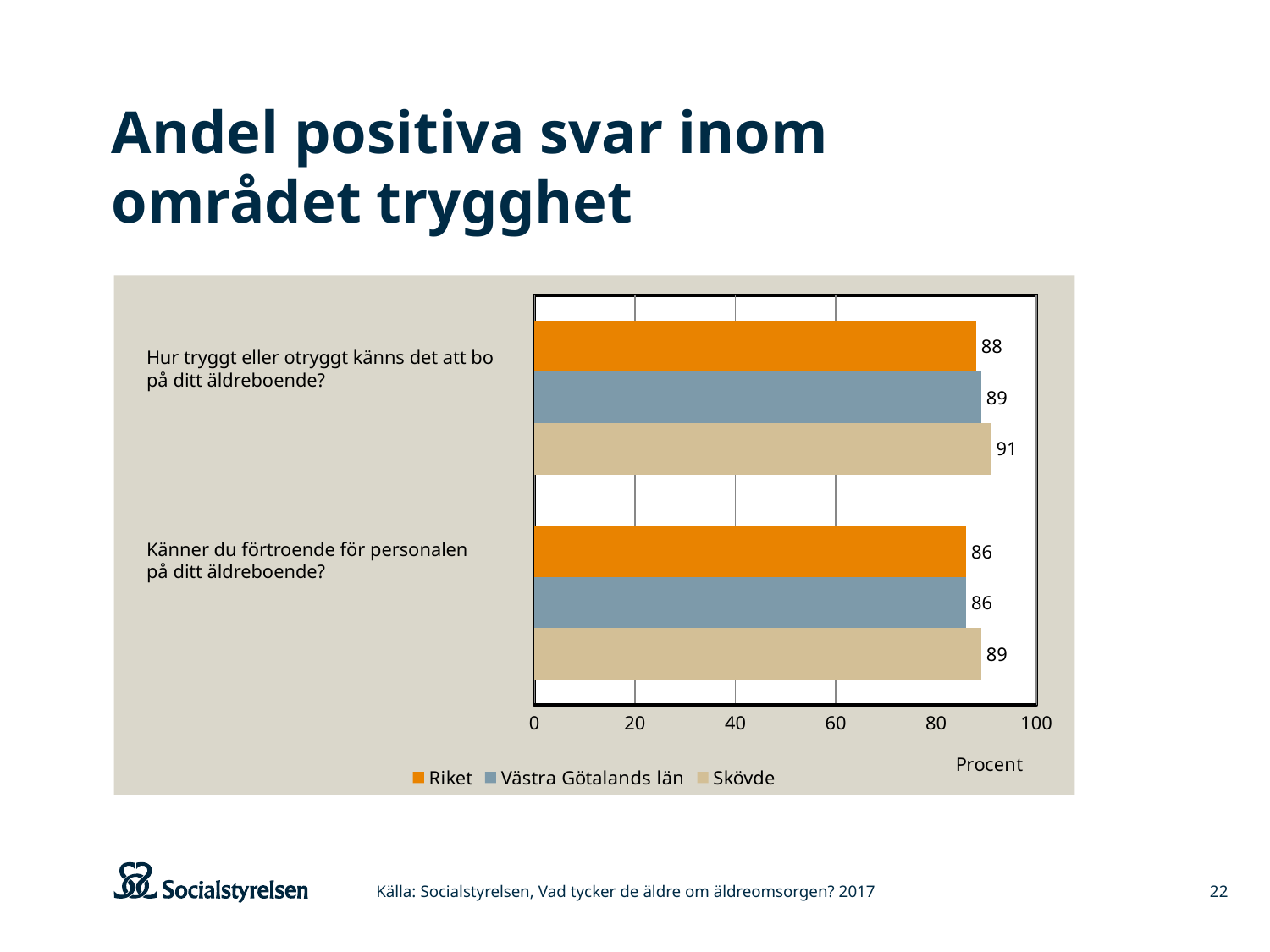
What is the value for Skövde on the question "Hur tryggt eller otryggt känns det att bo på ditt äldreboende?"? 91 What is the value for Västra Götalands län on the question "Hur tryggt eller otryggt känns det att bo på ditt äldreboende?"? 89 Which is larger: the Skövde value for "Hur tryggt eller otryggt känns det att bo på ditt äldreboende?" or the Skövde value for "Känner du förtroende för personalen på ditt äldreboende?"? Hur tryggt eller otryggt känns det att bo på ditt äldreboende? Which series has the highest value on the question "Hur tryggt eller otryggt känns det att bo på ditt äldreboende?"? Skövde Is the value for Riket on "Hur tryggt eller otryggt känns det att bo på ditt äldreboende?" greater or less than 80? greater What kind of chart is shown on the slide? Bar chart How many questions (categories) are shown in the chart? 2 How many series does the legend list? 3 Which series has the lowest value on the question "Hur tryggt eller otryggt känns det att bo på ditt äldreboende?"? Riket What is the value for Riket on the question "Känner du förtroende för personalen på ditt äldreboende?"? 86 What is the unit label shown on the x axis of the chart? Procent What is the difference between the Skövde and Riket values on the question "Känner du förtroende för personalen på ditt äldreboende?"? 3